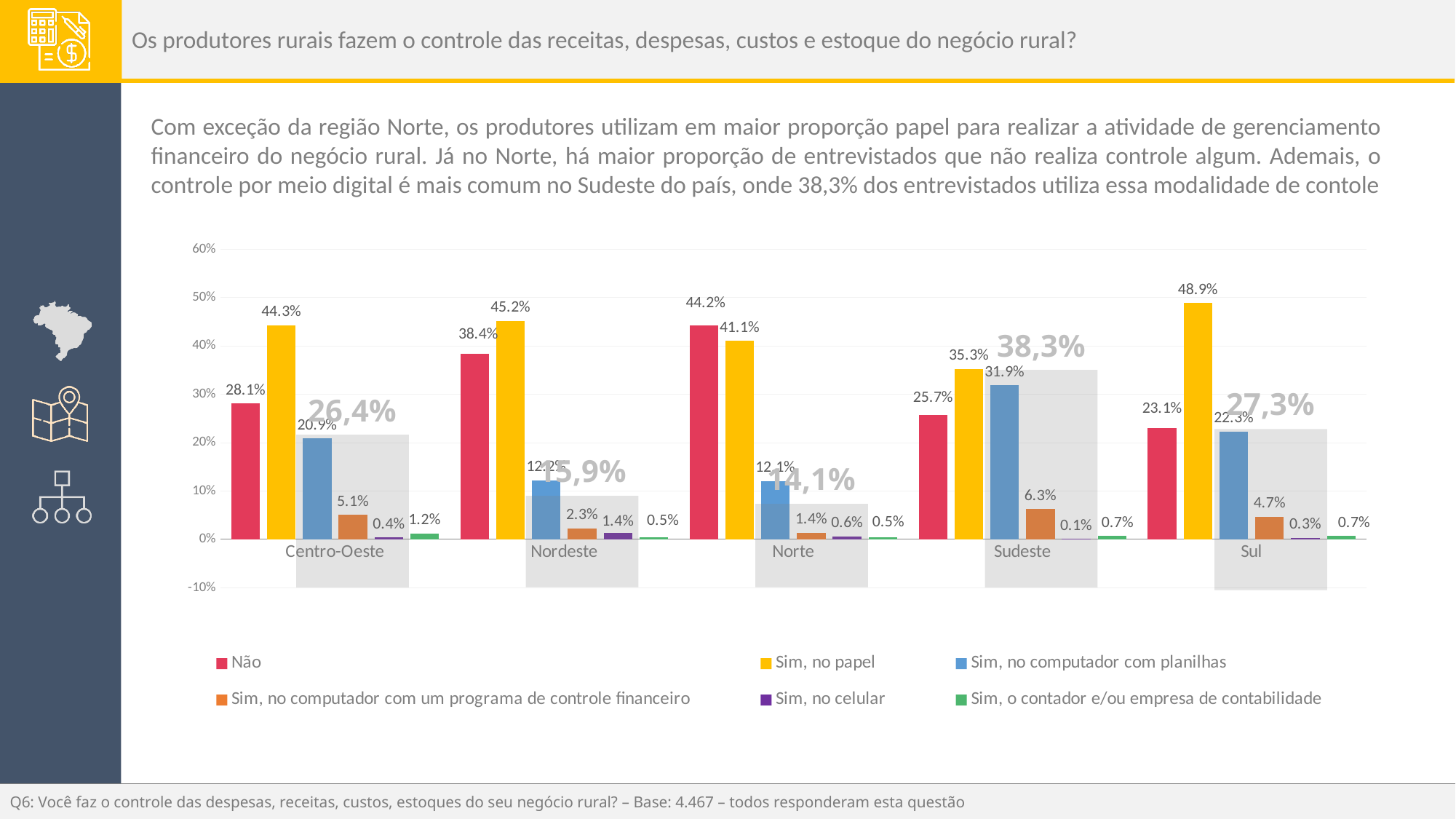
Which region has the highest value for "Sim, no papel"? Sul How many regions are shown on the x axis? 5 What is the value for "Sim, no computador com planilhas" in the Sudeste region? 31.9% How many series does the legend list? 6 Which region has the highest large grey percentage label shown over its bars? Sudeste In the Norte region, which is larger: "Não" or "Sim, no papel"? Não What kind of chart is shown on the slide? bar chart What is the value for "Sim, no computador com um programa de controle financeiro" in the Sudeste region? 6.3% Which region has the lowest value for "Não"? Sul What is the value for "Sim, no papel" in the Sul region? 48.9% What is the difference between "Sim, no papel" and "Não" in the Centro-Oeste region? 16.2% What is the value for "Não" in the Norte region? 44.2%